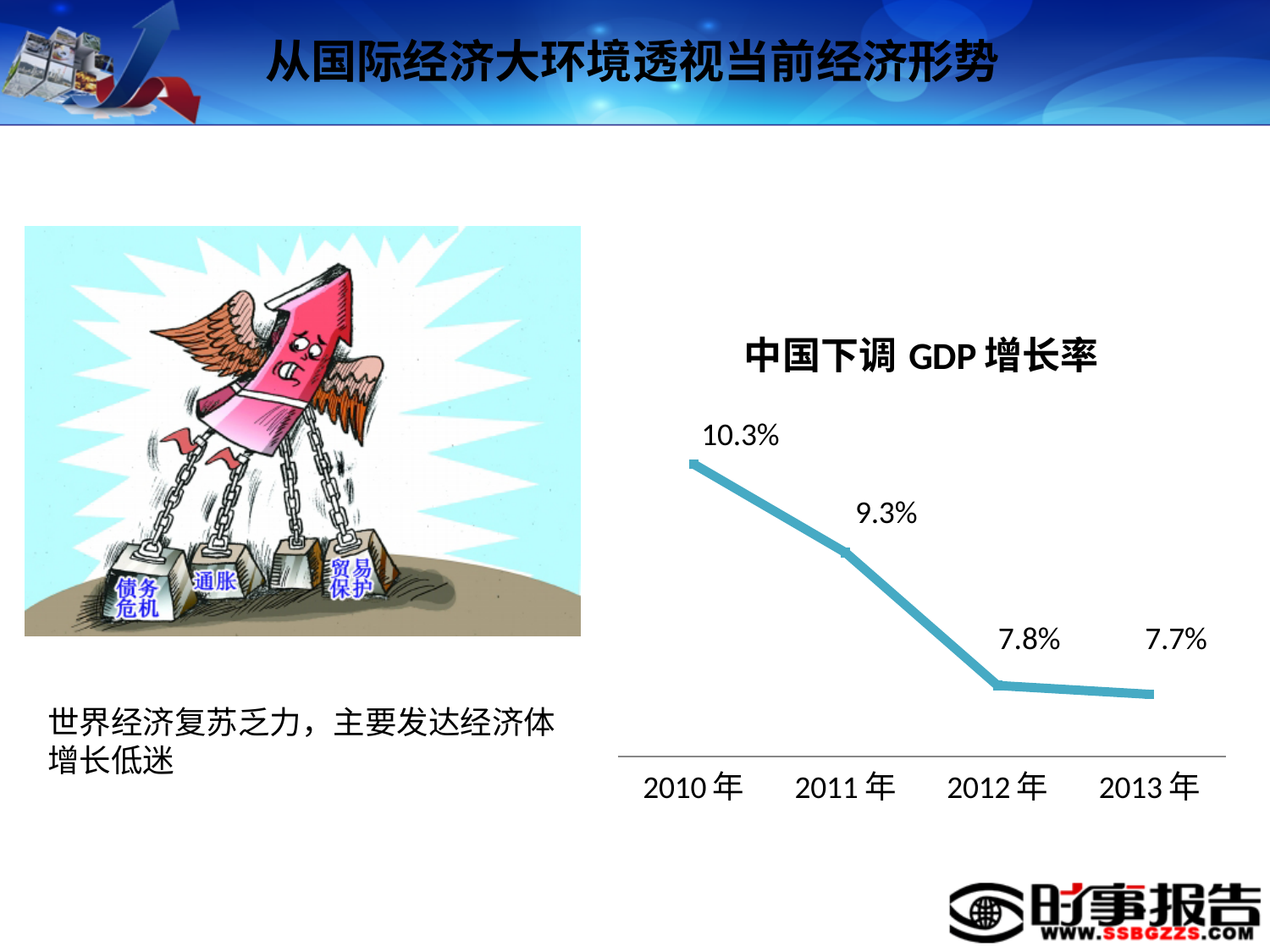
What is the GDP growth rate shown for 2010年? 10.3% What is the title of the chart? 中国下调 GDP 增长率 What is the GDP growth rate shown for 2012年? 7.8% What is the difference between the GDP growth rates for 2010年 and 2011年? 1.0% Which year has the highest GDP growth rate in the chart? 2010年 Do the GDP growth rates rise or fall from 2010年 to 2013年? fall How many years are plotted in the chart? 4 Which year has the lowest GDP growth rate in the chart? 2013年 What is the GDP growth rate shown for 2013年? 7.7% Which is larger, the GDP growth rate for 2011年 or for 2013年? 2011年 What is the difference between the GDP growth rates for 2011年 and 2012年? 1.5% What kind of chart is used to show China's GDP growth rate? line chart